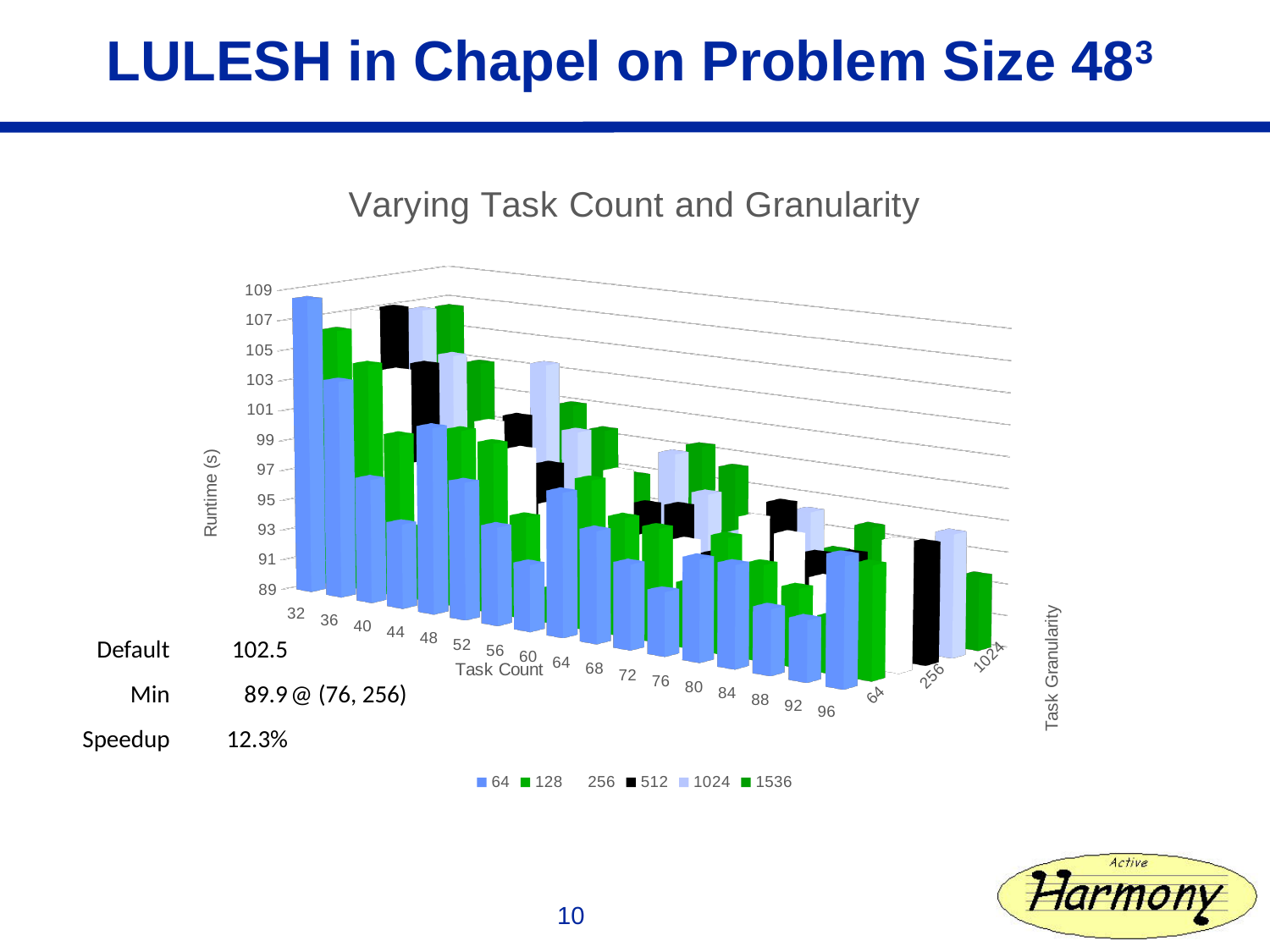
Is the runtime for the 64 granularity series at task count 32 greater or less than the runtime at task count 96? greater What are the task granularity values listed in the legend? 64, 128, 256, 512, 1024, 1536 How many series does the chart's legend list? 6 What kind of chart is shown on the slide? bar chart What is the title of the chart? Varying Task Count and Granularity For the 64 granularity series, does runtime rise or fall as task count increases from 32 to 96? fall For the 64 granularity series, which task count has the highest runtime? 32 How many task count categories are shown along the x axis? 17 Is the runtime for the 64 granularity series at task count 32 greater or less than 105? greater What is the default runtime value stated on the slide? 102.5 What speedup is stated on the slide? 12.3% What is the minimum runtime stated on the slide, and at which (task count, granularity) does it occur? 89.9 @ (76, 256)